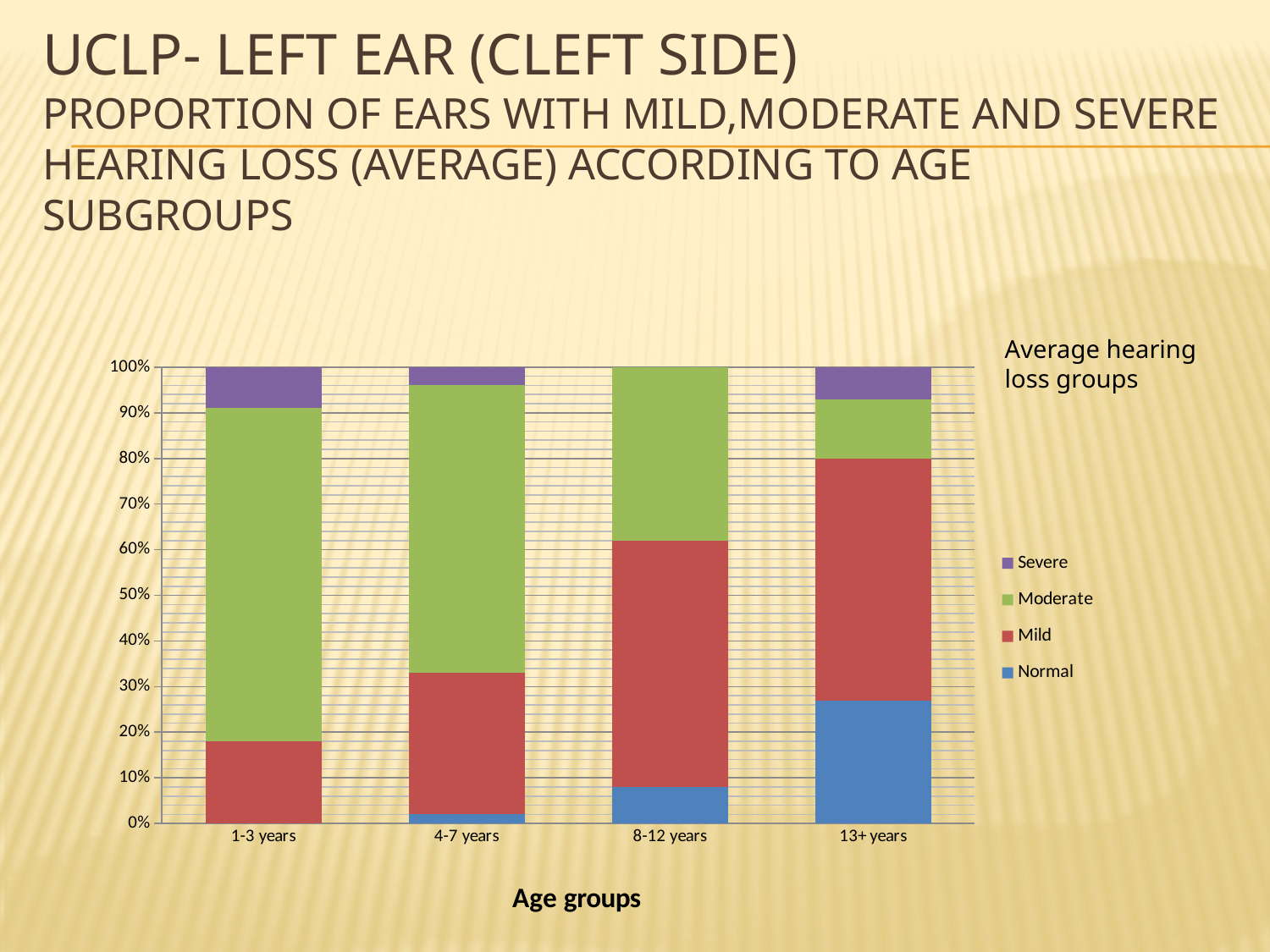
What is the title of the x axis? Age groups Which age group shows no visible Severe segment? 8-12 years Which has the larger Mild share, 1-3 years or 4-7 years? 4-7 years Does the Normal share rise or fall as the age groups increase from 1-3 years to 13+ years? rise Which age group has the largest Moderate share? 1-3 years What is the title shown above the legend? Average hearing loss groups How many age groups are shown on the x axis? 4 Which age group shows no visible Normal segment? 1-3 years How many series does the legend list? 4 What kind of chart is shown on the slide? Stacked bar chart Which age group has the largest Normal share? 13+ years Is the Normal share for 13+ years greater or less than 20%? greater